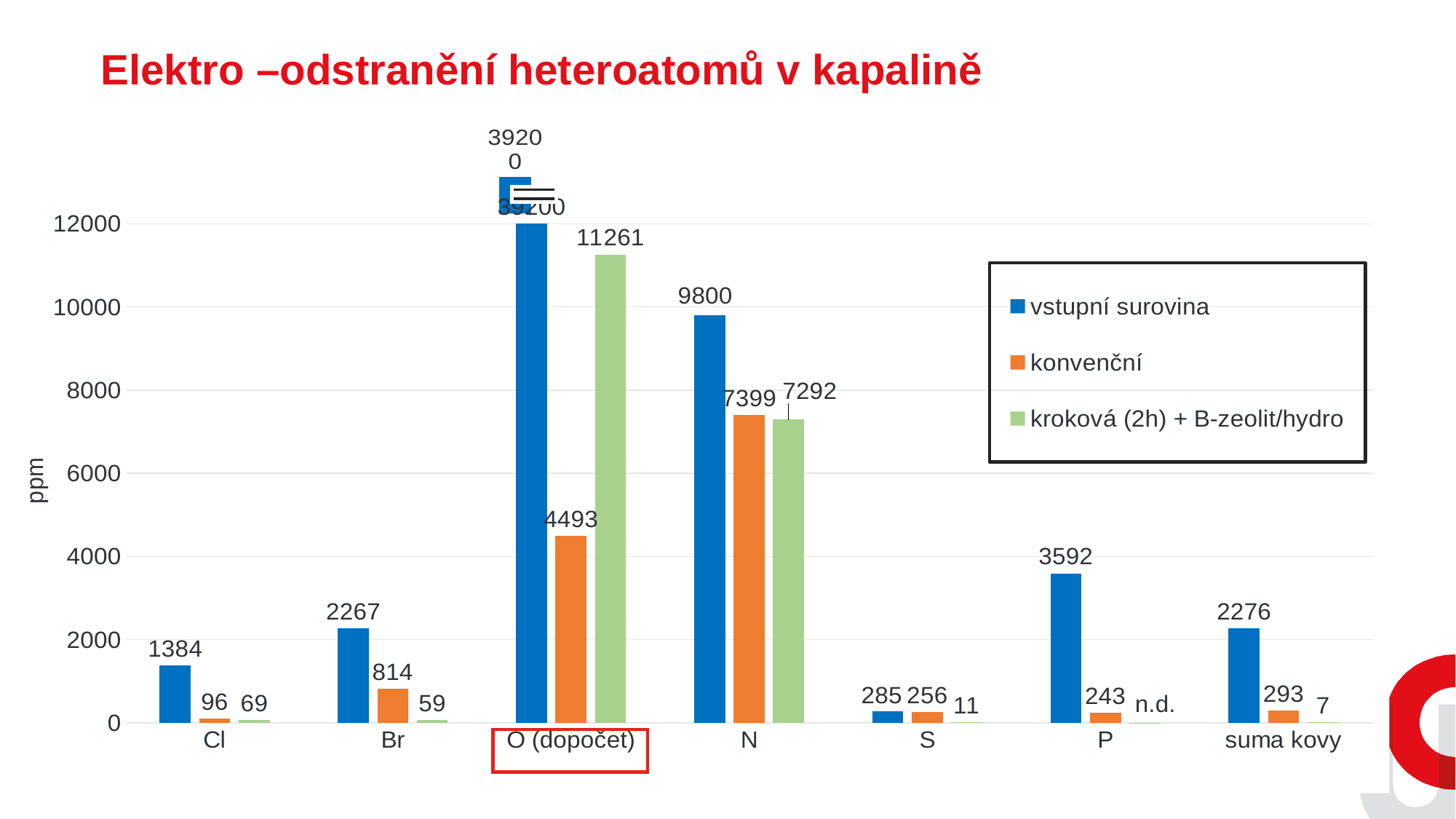
What is the value for vstupní surovina for N? 9800 What is the difference between the vstupní surovina values for P and suma kovy? 1316 What is the value for kroková (2h) + B-zeolit/hydro for O (dopočet)? 11261 What is the label of the y axis? ppm What is the value for konvenční for Br? 814 Which category has the lowest vstupní surovina value? S Which is larger for Cl: the konvenční value or the kroková (2h) + B-zeolit/hydro value? konvenční How many series does the legend list? 3 What type of chart is shown on the slide? bar chart How many categories are shown on the x axis? 7 What is the difference between the vstupní surovina and konvenční values for N? 2401 What is the value for kroková (2h) + B-zeolit/hydro for P? n.d.